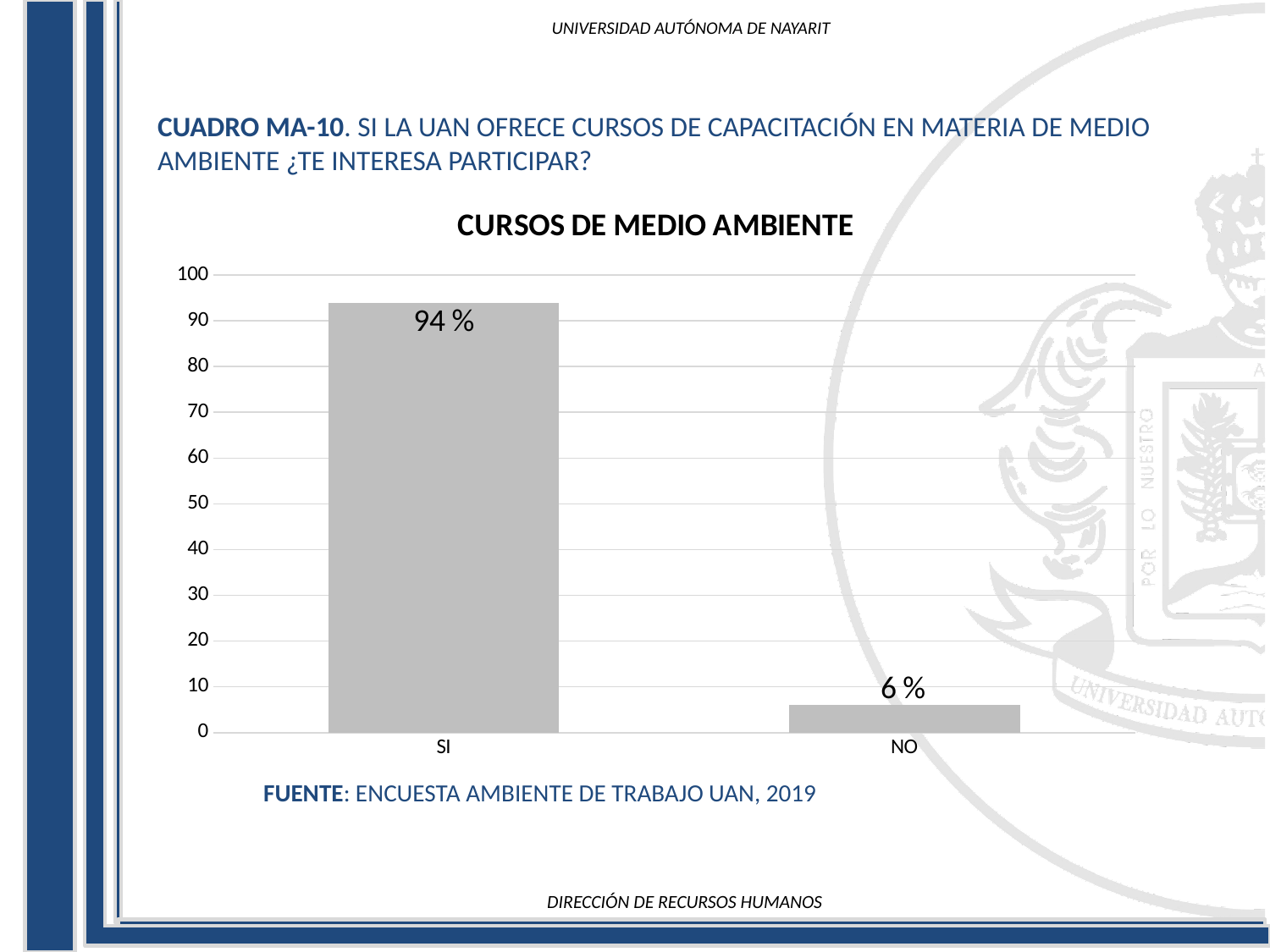
What is the value for NO? 6 % What is the value for SI? 94 % Is the value for NO greater or less than 10? less How many categories are shown on the x axis? 2 What is the difference between the values for SI and NO? 88 % What is the title of the chart? CURSOS DE MEDIO AMBIENTE Which is larger, the value for SI or the value for NO? SI What kind of chart is shown? bar chart Which category has the lowest value? NO What is the maximum value shown on the y axis? 100 Is the value for SI greater or less than 90? greater Which category has the highest value? SI